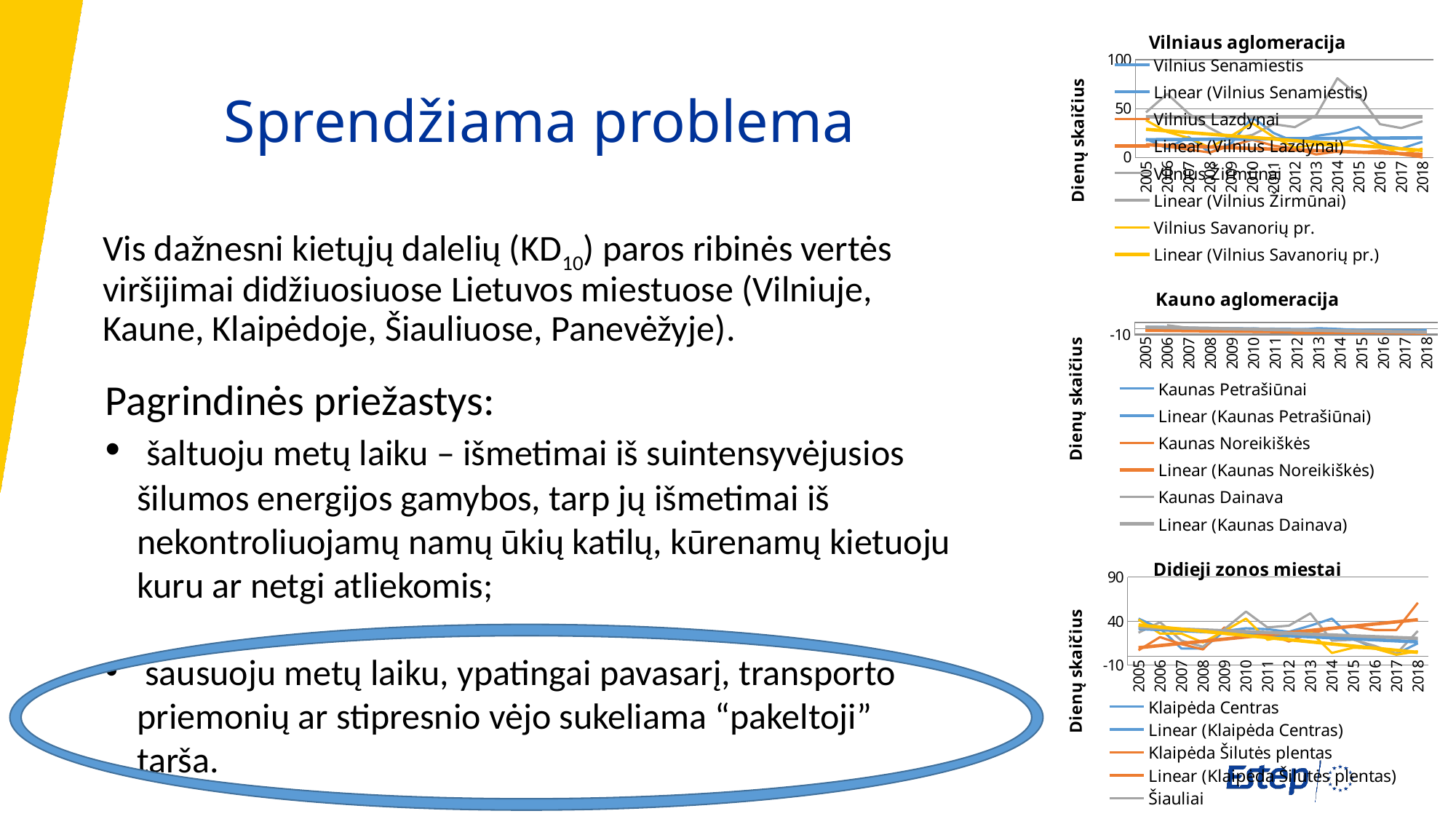
How many series does the legend of the "Vilniaus aglomeracija" chart list? 8 What kind of chart is the "Vilniaus aglomeracija" chart? Line chart In the "Didieji zonos miestai" chart, is the value for Klaipėda Šilutės plentas in 2018 greater or less than 40? greater In the "Vilniaus aglomeracija" chart, what is the first year on the x axis? 2005 In the "Vilniaus aglomeracija" chart, is the value for Vilnius Senamiestis in 2018 greater or less than 50? less In the "Didieji zonos miestai" chart, what is the last year on the x axis? 2018 In the "Didieji zonos miestai" chart, does the Linear (Klaipėda Šilutės plentas) trend line rise or fall from 2005 to 2018? Rise How many years are shown on the x axis of the "Vilniaus aglomeracija" chart? 14 In the "Vilniaus aglomeracija" chart, is the value for Vilnius Žirmūnai in 2014 greater or less than 50? greater What is the y-axis label of the "Kauno aglomeracija" chart? Dienų skaičius How many series does the legend of the "Kauno aglomeracija" chart list? 6 What kind of chart is the "Didieji zonos miestai" chart? Line chart